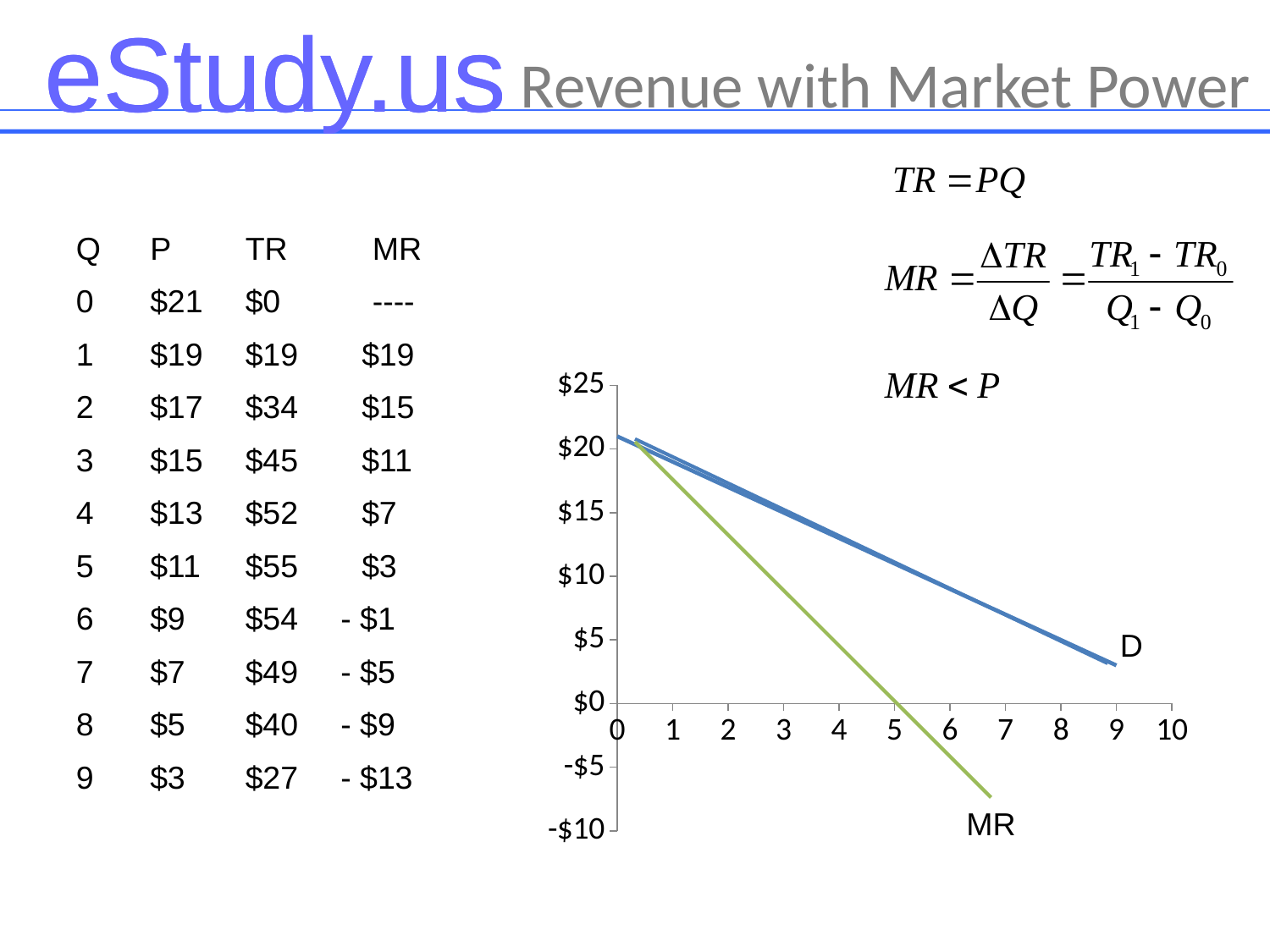
What is the highest value labelled on the chart's vertical axis? $25 Does the D line rise or fall as quantity increases along the x axis? fall How many lines are plotted on the chart? 2 What kind of chart is shown on the slide? line chart At a quantity of 8, which line is higher, D or MR? D Is the value of the D line at a quantity of 2 greater or less than $15? greater Is the value of the D line at a quantity of 9 greater or less than $5? less Is the value of the MR line at a quantity of 7 greater or less than $0? less What are the labels of the two lines on the chart? D and MR How many tick labels are shown on the chart's horizontal axis? 11 Does the MR line rise or fall as quantity increases along the x axis? fall